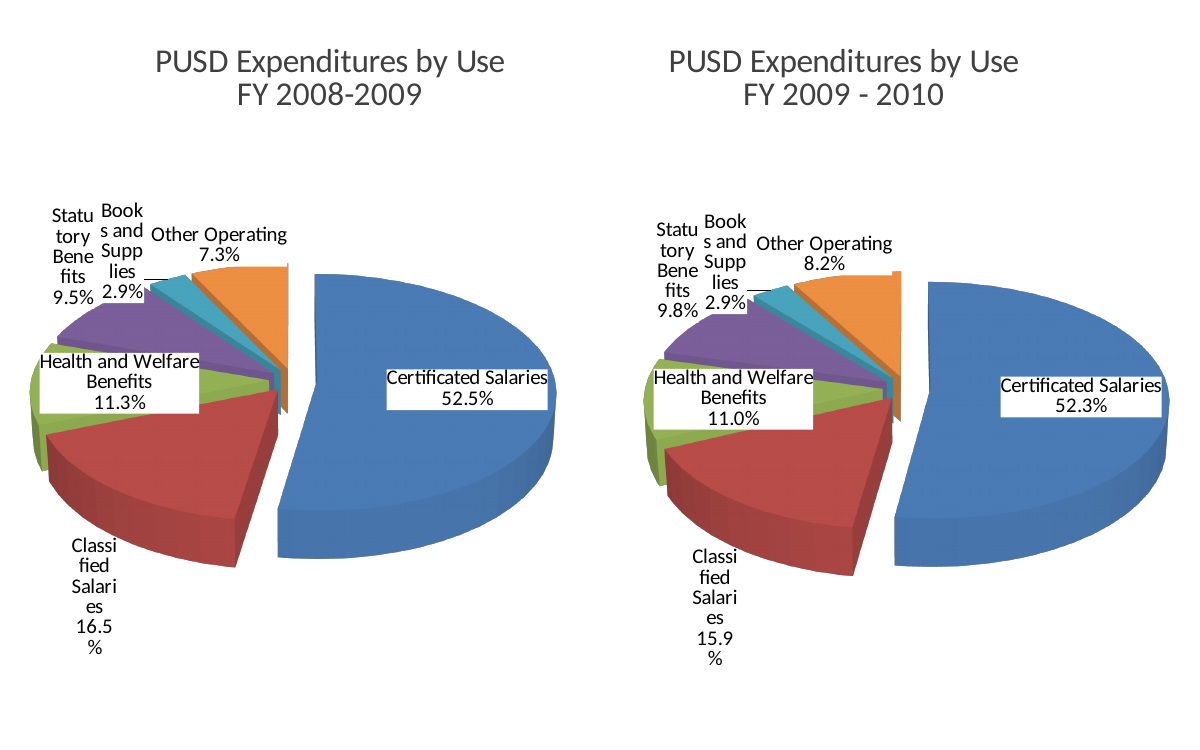
What type of chart is the 'PUSD Expenditures by Use FY 2009 - 2010' chart? Pie chart In the 'PUSD Expenditures by Use FY 2008-2009' chart, what share is Health and Welfare Benefits? 11.3% In the 'PUSD Expenditures by Use FY 2008-2009' chart, which category has the largest share? Certificated Salaries In the 'PUSD Expenditures by Use FY 2009 - 2010' chart, what share is Classified Salaries? 15.9% In the 'PUSD Expenditures by Use FY 2008-2009' chart, what is the difference between the Classified Salaries share and the Health and Welfare Benefits share? 5.2% How many charts are shown on the slide? 2 In the 'PUSD Expenditures by Use FY 2008-2009' chart, what share is Certificated Salaries? 52.5% In the 'PUSD Expenditures by Use FY 2009 - 2010' chart, what share is Statutory Benefits? 9.8% In the 'PUSD Expenditures by Use FY 2009 - 2010' chart, which category has the smallest share? Books and Supplies In the 'PUSD Expenditures by Use FY 2009 - 2010' chart, what share is Other Operating? 8.2% How many categories does the 'PUSD Expenditures by Use FY 2008-2009' chart show? 6 In the 'PUSD Expenditures by Use FY 2009 - 2010' chart, which is larger: Statutory Benefits or Other Operating? Statutory Benefits